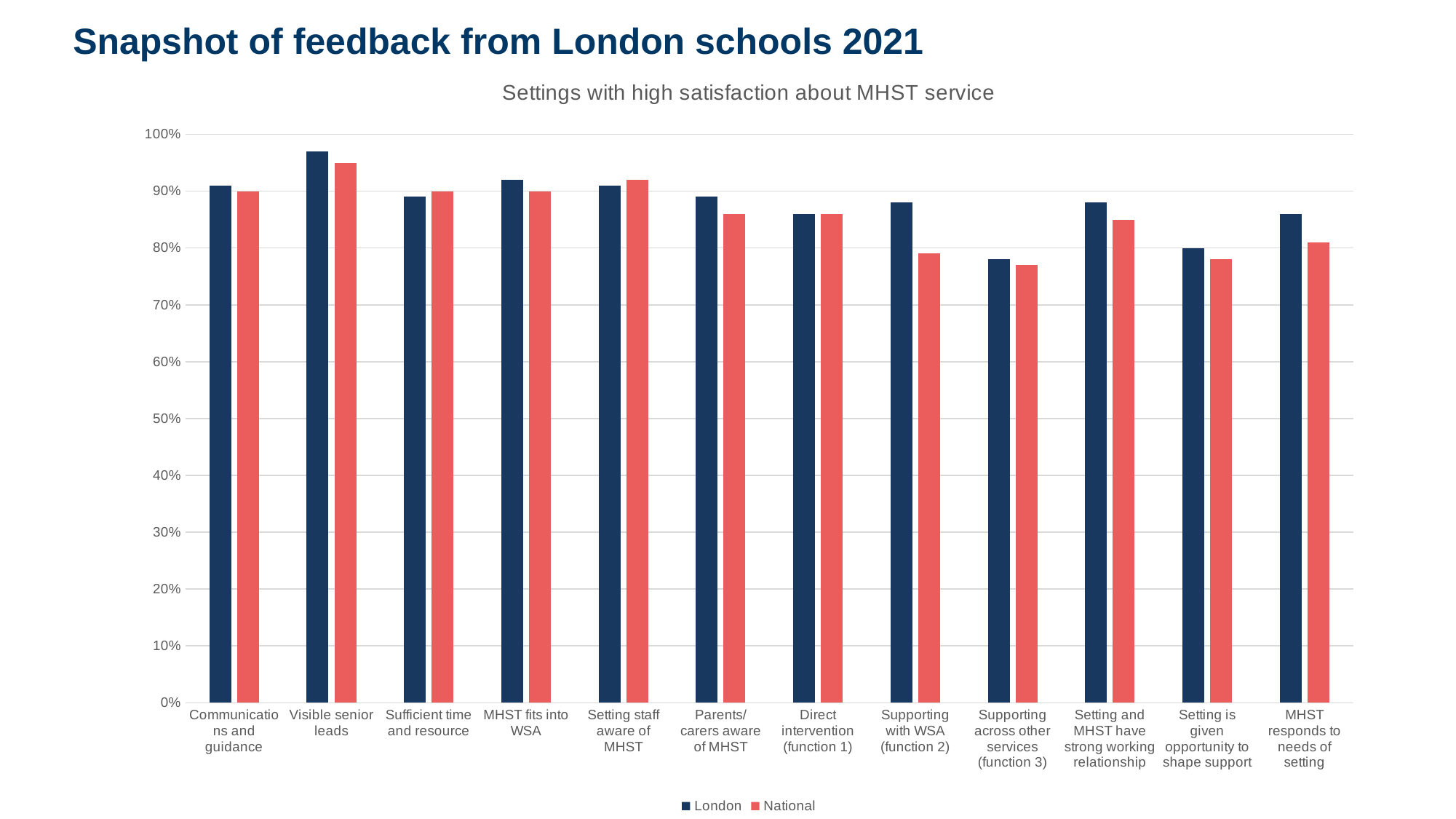
How many categories are shown on the x axis? 12 Which category has the highest London value? Visible senior leads Is the National value for Visible senior leads greater or less than 90%? greater Which is larger for MHST responds to needs of setting, the London value or the National value? London How many series does the legend list? 2 Which category has the lowest London value? Supporting across other services (function 3) Which is larger for Visible senior leads, the London value or the National value? London What kind of chart is shown on the slide? Bar chart What is the title of the chart? Settings with high satisfaction about MHST service Is the London value for Supporting across other services (function 3) greater or less than 80%? less Which is larger for Supporting with WSA (function 2), the London value or the National value? London